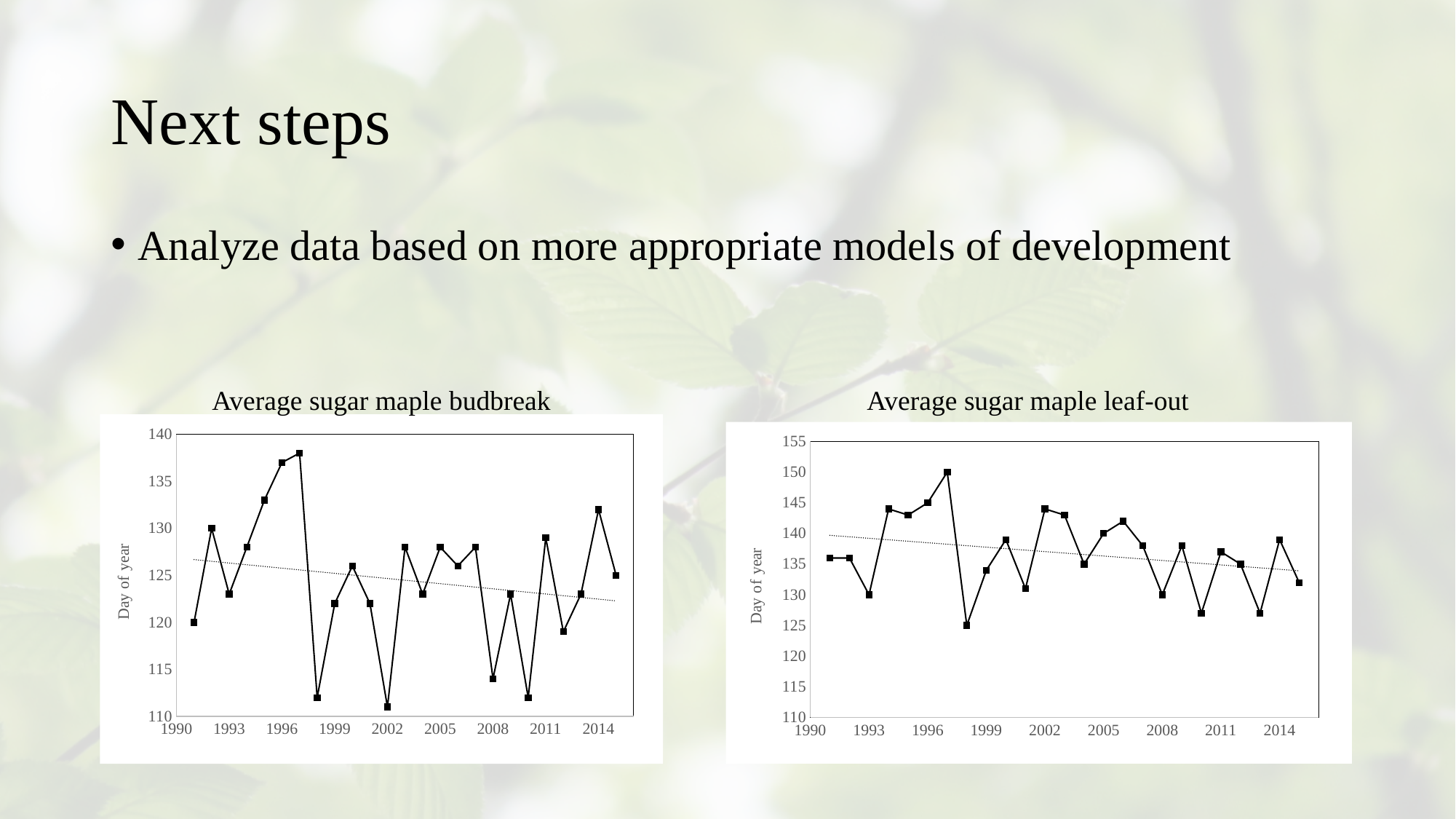
In the 'Average sugar maple leaf-out' chart, does the dotted trend line rise or fall from left to right? fall In the 'Average sugar maple leaf-out' chart, which year has the larger value, 1993 or 2002? 2002 In the 'Average sugar maple budbreak' chart, is the value for 2002 greater or less than 115? less In the 'Average sugar maple leaf-out' chart, is the value for 1996 greater or less than 140? greater In the 'Average sugar maple leaf-out' chart, is the value for 2008 greater or less than 135? less What kind of chart is the 'Average sugar maple budbreak' chart? line chart In the 'Average sugar maple budbreak' chart, which year has the larger value, 1996 or 1999? 1996 In the 'Average sugar maple budbreak' chart, does the dotted trend line rise or fall from left to right? fall What is the y-axis label on the 'Average sugar maple leaf-out' chart? Day of year What kind of chart is the 'Average sugar maple leaf-out' chart? line chart